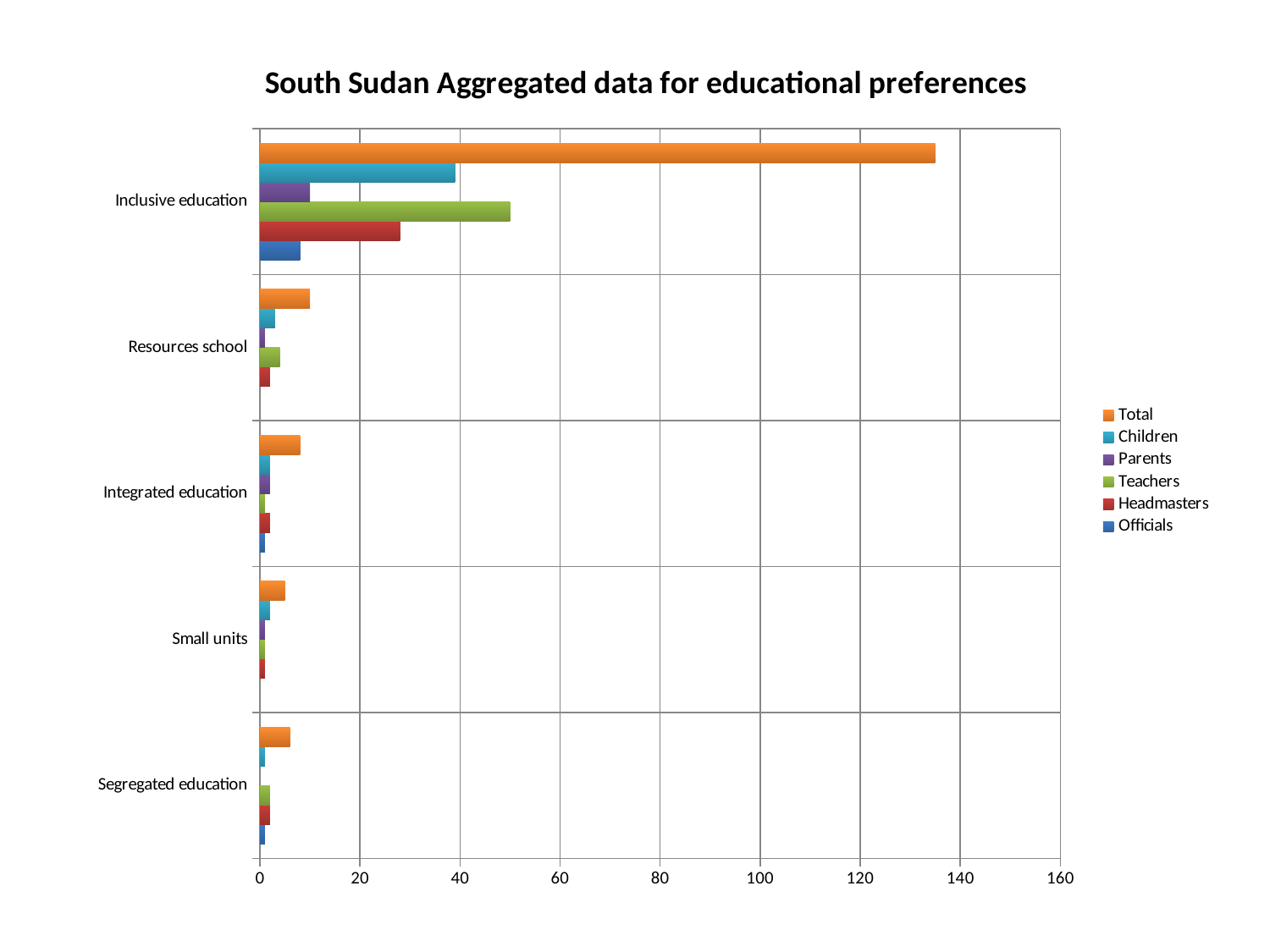
Is the Headmasters value for Inclusive education greater or less than 20? greater Is the Teachers value for Inclusive education greater or less than 40? greater Is the Total value for Inclusive education greater or less than 140? less What type of chart is shown on the slide? Bar chart What is the title of the chart? South Sudan Aggregated data for educational preferences Which has the larger Total value: Resources school or Small units? Resources school How many educational preference categories are shown on the chart? 5 For Inclusive education, which is larger: the Teachers value or the Children value? Teachers Which colour represents the Total series in the legend? Orange Which category has the highest Total value? Inclusive education How many series does the legend list? 6